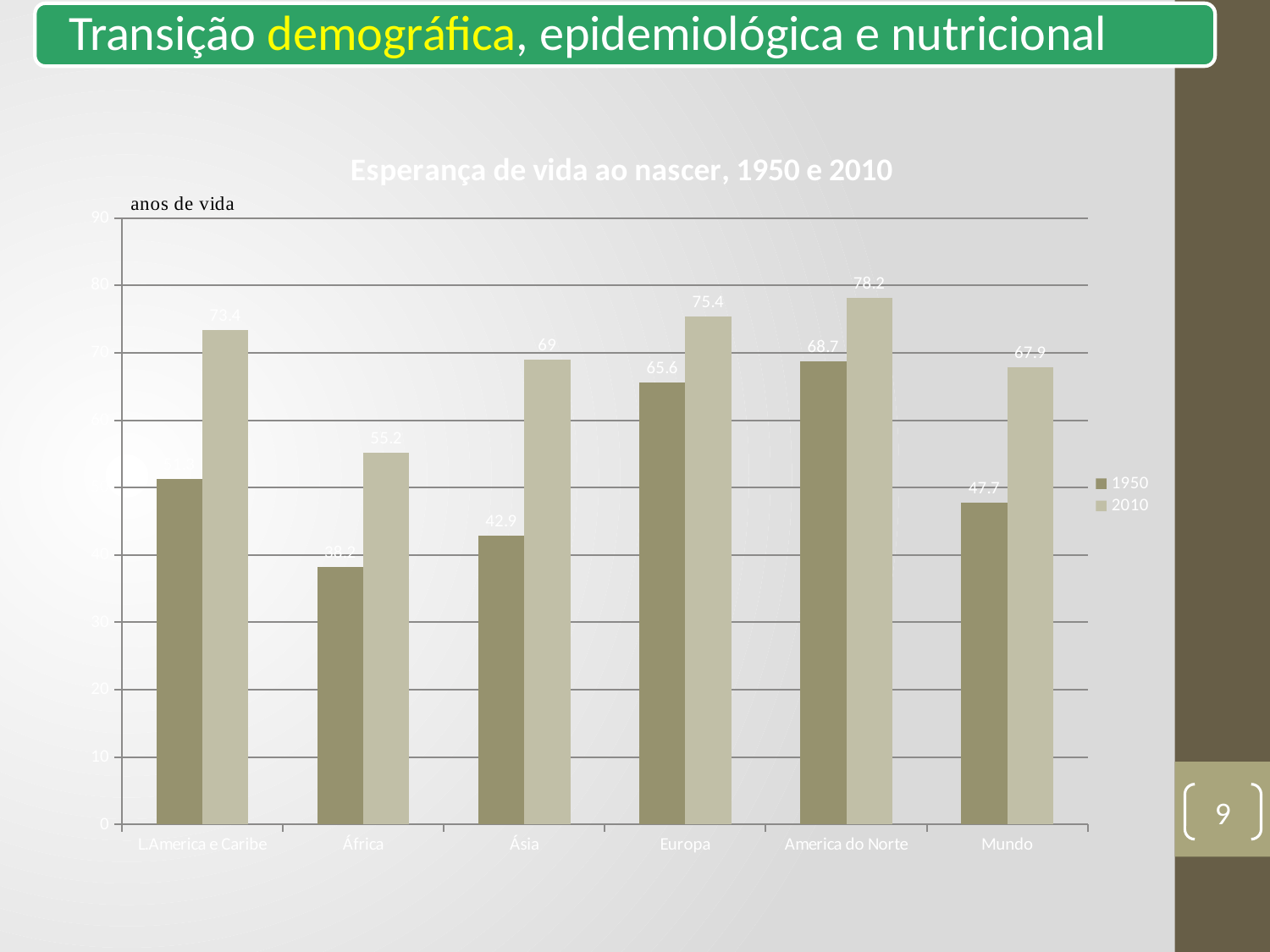
Is the 1950 value for L.America e Caribe greater or less than 60? less What is the 2010 life expectancy value shown for Europa? 75.4 By how much did the value for Ásia increase from 1950 to 2010? 26.1 How many series does the legend list? 2 What kind of chart is shown on the slide? bar chart Which region has the highest 2010 value? America do Norte How many regions are shown on the x axis? 6 Which region has the lowest 2010 value? África What is the 1950 value shown for America do Norte? 68.7 Which is larger in 2010: L.America e Caribe or Europa? Europa What is the title of the chart? Esperança de vida ao nascer, 1950 e 2010 What is the 2010 value shown for Mundo? 67.9